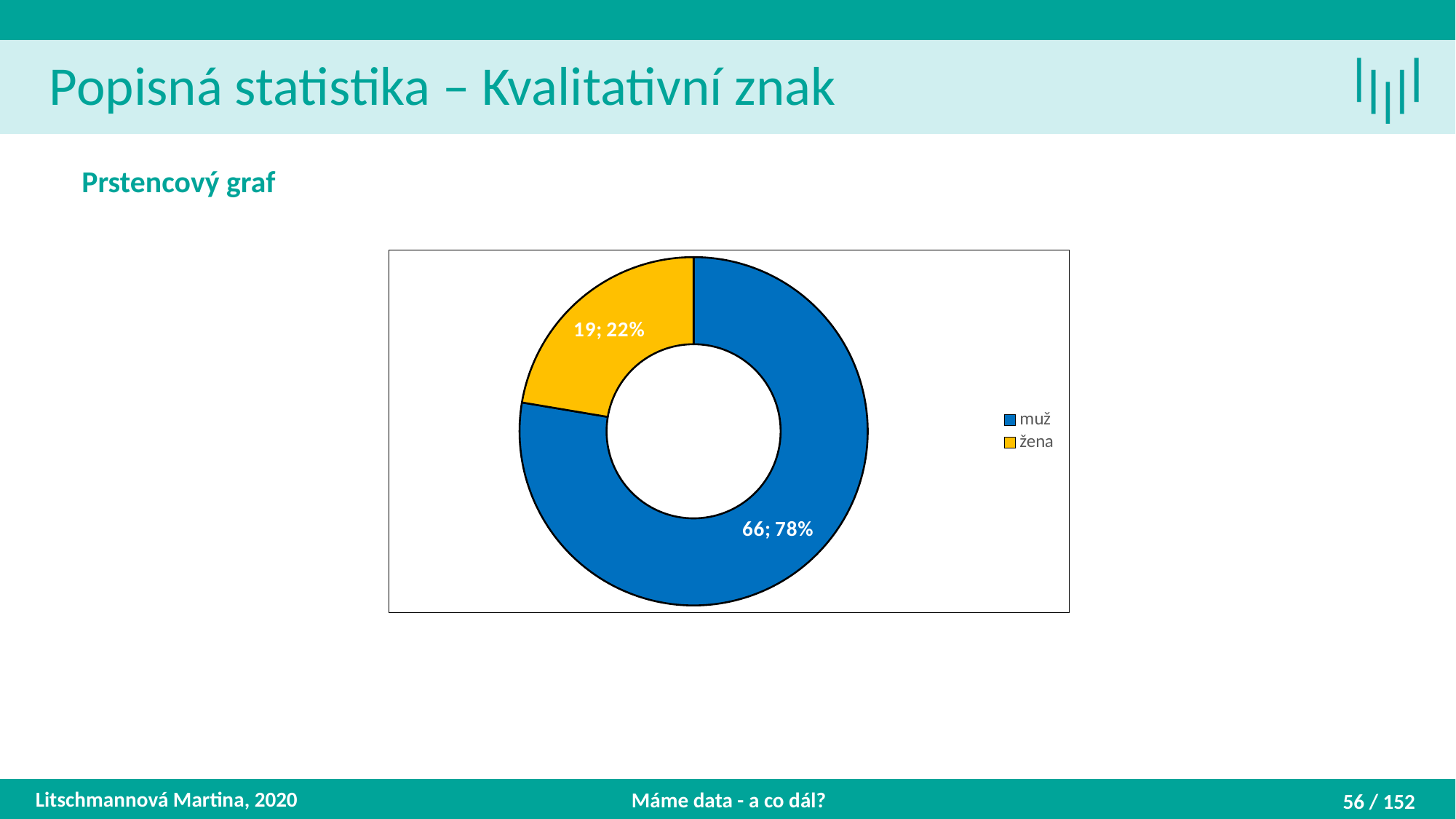
How many categories does the doughnut chart show? 2 What share of the doughnut does žena represent? 22% What is the difference between the counts for muž and žena? 47 What is the count for muž? 66 What kind of chart is shown on the slide? doughnut chart Which category has the largest slice? muž Which category has the smallest slice? žena What is the total of the counts for muž and žena? 85 What share of the doughnut does muž represent? 78% Which colour represents žena in the chart? yellow How many entries does the legend list? 2 What is the count for žena? 19